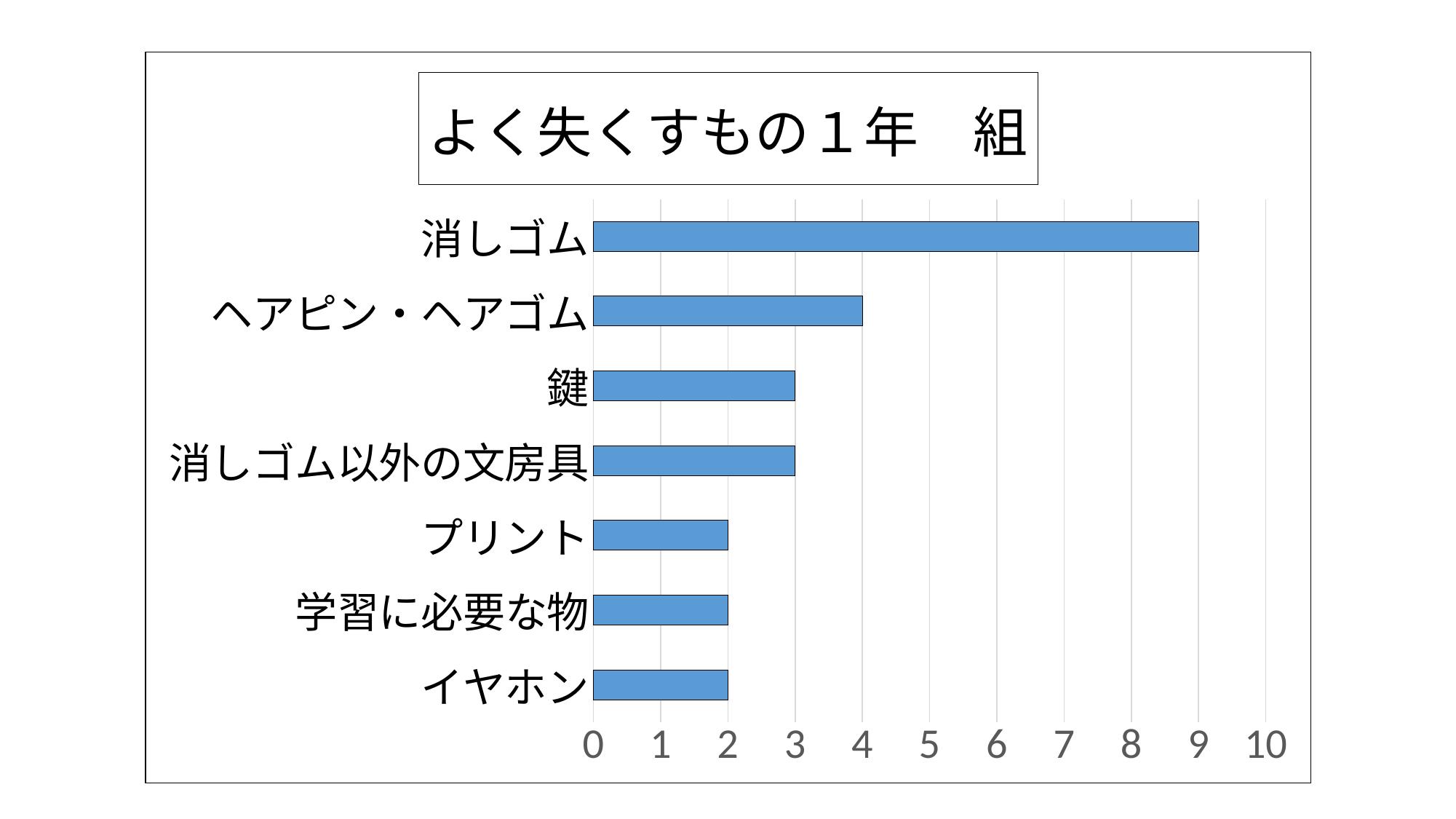
Which is larger, the value for ヘアピン・ヘアゴム or the value for プリント? ヘアピン・ヘアゴム What is the value for 鍵? 3 What is the highest value shown on the horizontal axis? 10 What is the value for 消しゴム? 9 What is the value for ヘアピン・ヘアゴム? 4 What kind of chart is shown on the slide? bar chart What is the difference between the values for 消しゴム and ヘアピン・ヘアゴム? 5 How many categories are shown in the chart? 7 What is the title of the chart? よく失くすもの１年 組 What is the value for イヤホン? 2 Is the value for 消しゴム greater or less than 5? greater Which category has the highest value? 消しゴム